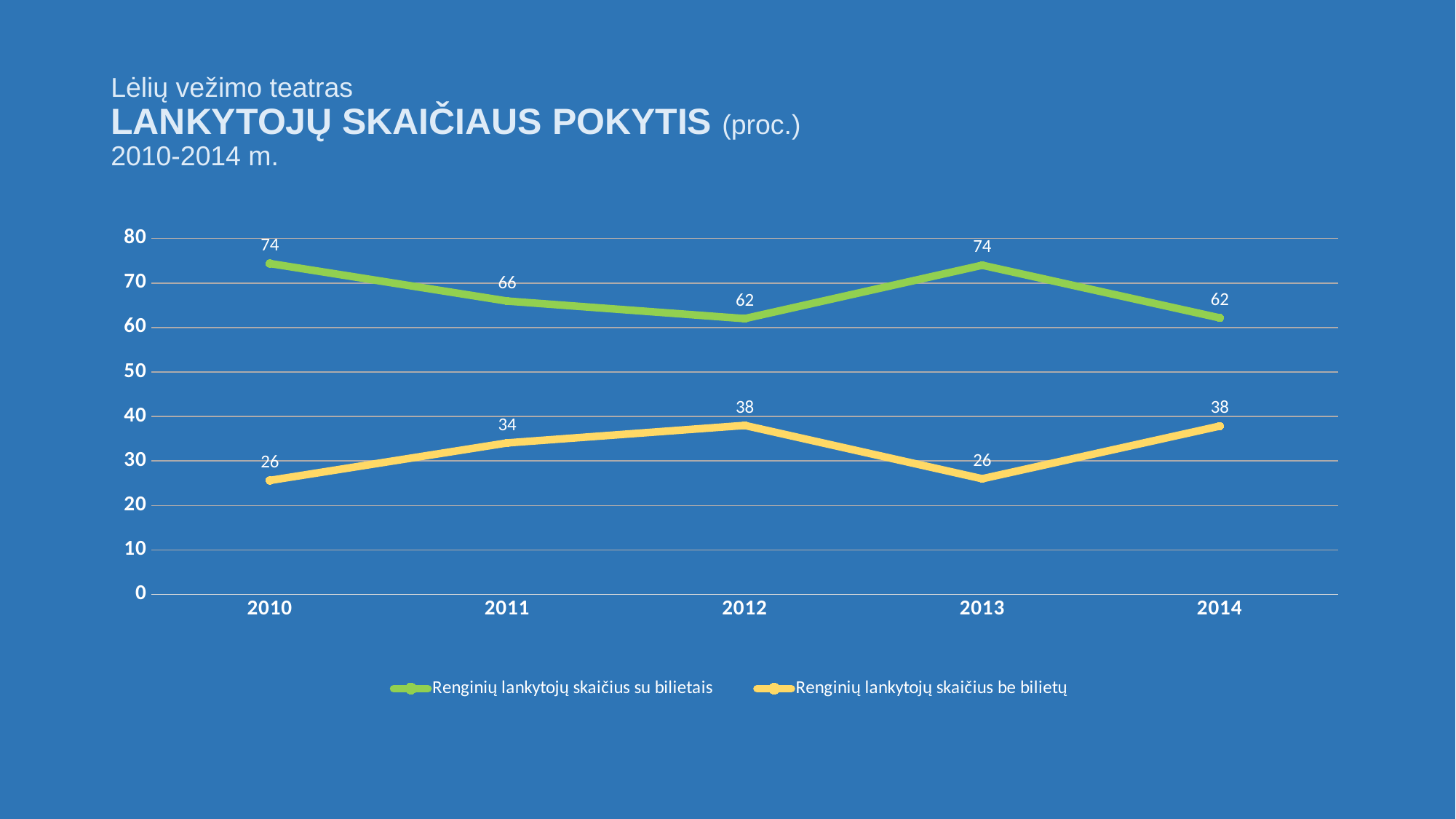
What is the difference between 'Renginių lankytojų skaičius su bilietais' in 2010 and in 2012? 12 What is the difference between the two series in 2011? 32 How many years are shown on the x axis? 5 In which year is 'Renginių lankytojų skaičius be bilietų' lowest? 2010 and 2013 Which series has the larger value in 2013? Renginių lankytojų skaičius su bilietais How many series does the legend list? 2 What is the value for 'Renginių lankytojų skaičius be bilietų' in 2012? 38 What is the value for 'Renginių lankytojų skaičius su bilietais' in 2010? 74 Is the value for 'Renginių lankytojų skaičius be bilietų' in 2011 greater or less than 30? greater What kind of chart is shown on the slide? line chart Does 'Renginių lankytojų skaičius su bilietais' rise or fall from 2010 to 2012? fall What is the value for 'Renginių lankytojų skaičius su bilietais' in 2014? 62